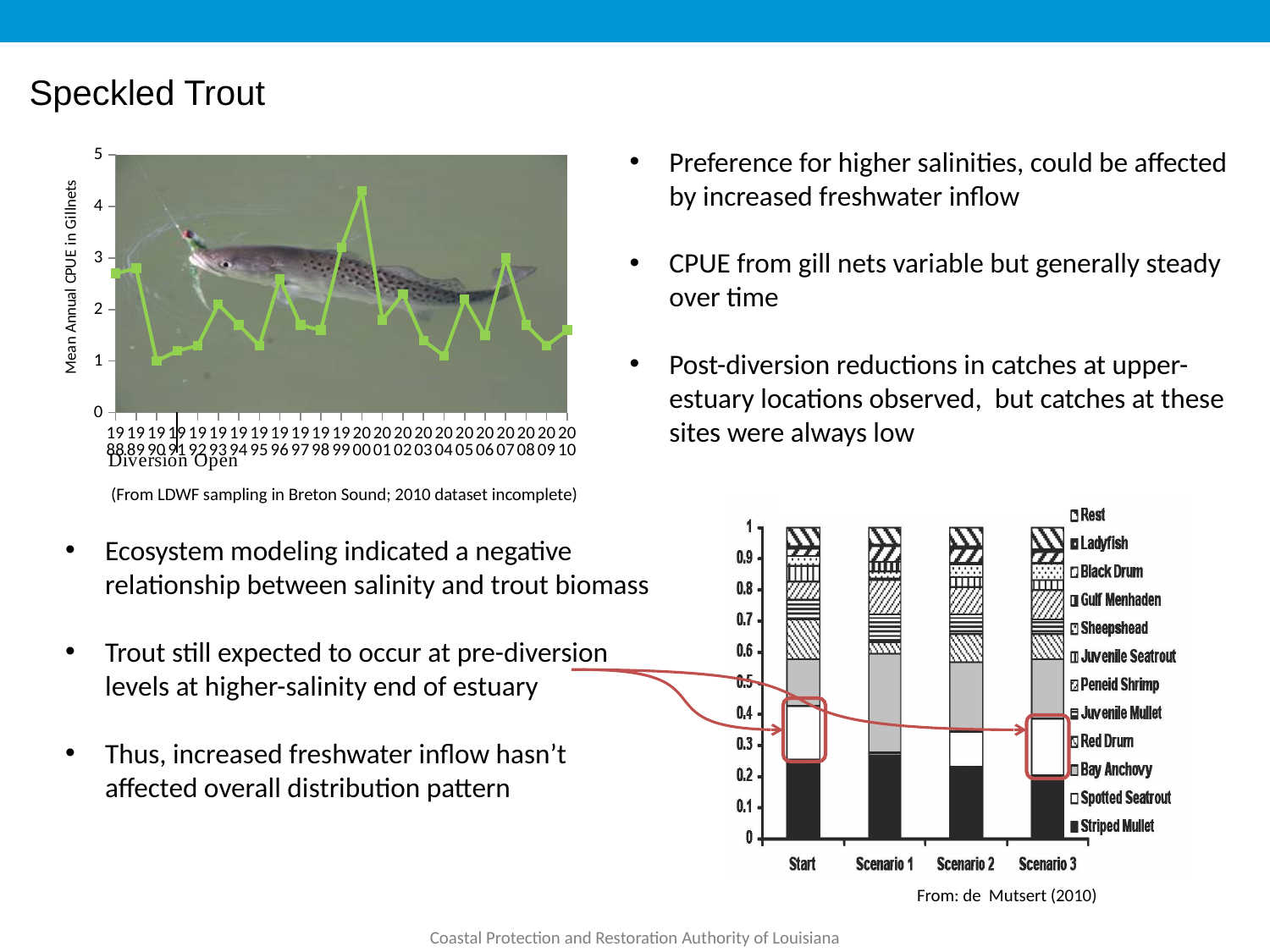
In the Mean Annual CPUE in Gillnets line chart, which year has the highest value? 2000 How many categories are shown on the x axis of the stacked bar chart on the lower right? 4 In the Mean Annual CPUE in Gillnets line chart, is the value for 1988 greater or less than 2? greater What is the y-axis label of the line chart on the left? Mean Annual CPUE in Gillnets What kind of chart is the chart on the left showing Mean Annual CPUE in Gillnets? line chart In the Mean Annual CPUE in Gillnets line chart, is the value for 1990 greater or less than 2? less How many years are plotted on the x axis of the Mean Annual CPUE in Gillnets line chart? 23 In the Mean Annual CPUE in Gillnets line chart, is the value for 2000 greater or less than 4? greater In the Mean Annual CPUE in Gillnets line chart, which year has the larger value, 2000 or 2004? 2000 In the stacked bar chart on the lower right, which category has the smallest Spotted Seatrout segment? Scenario 1 How many series does the legend of the stacked bar chart on the lower right list? 12 What kind of chart is the chart on the lower right with Start and Scenario categories? stacked bar chart